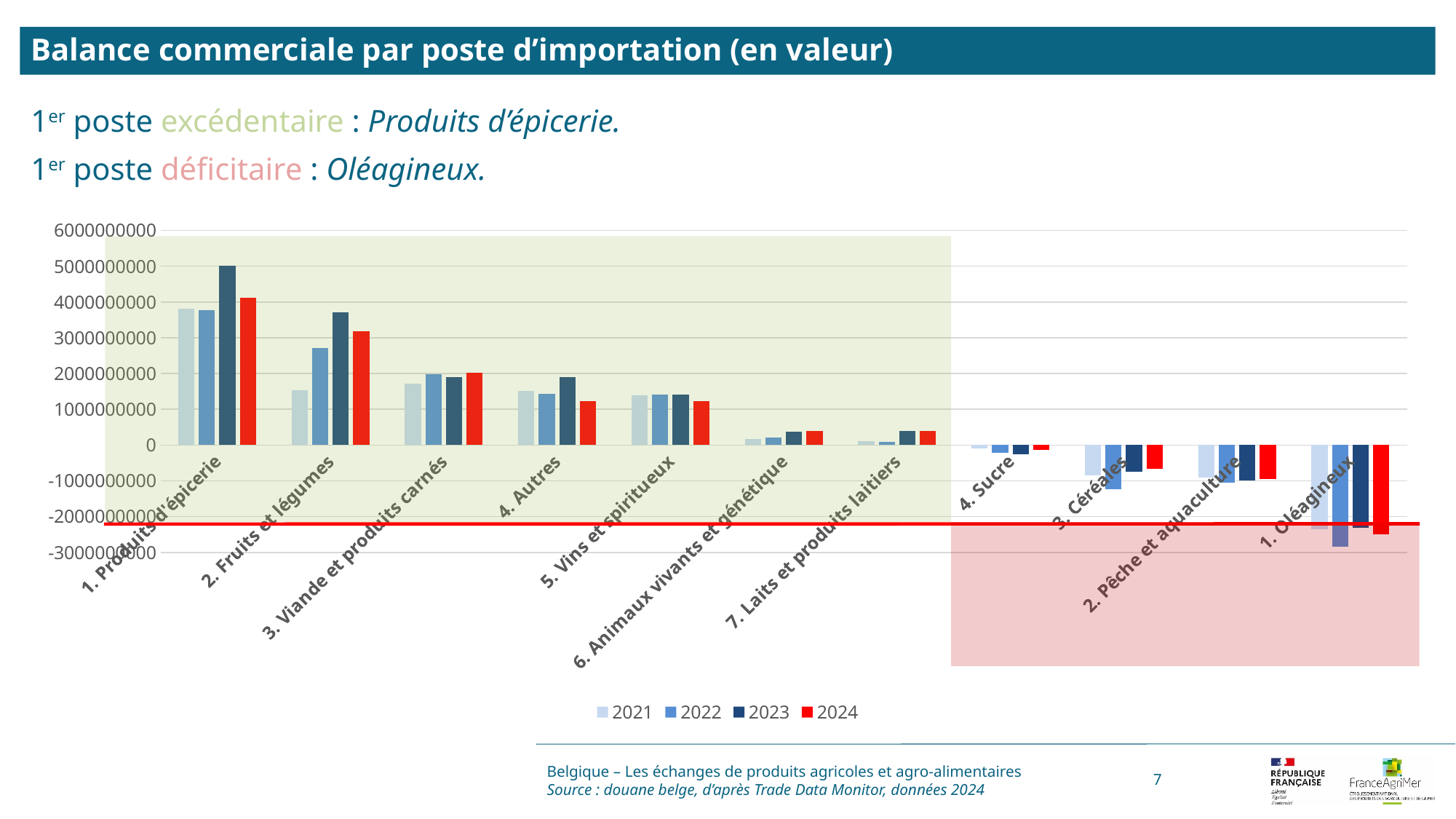
Which category has the highest value for 2024? 1. Produits d'épicerie How many series does the legend list? 4 What kind of chart is shown on the slide? bar chart What colour represents the 2024 series in the legend? red Is the 2024 value for 3. Céréales greater or less than -1000000000? greater How many categories are shown on the x axis? 11 Is the 2021 value for 2. Fruits et légumes greater or less than 1000000000? greater Is the 2022 value for 1. Oléagineux greater or less than -2000000000? less Which category has the lowest value for 2022? 1. Oléagineux Which is larger, the 2023 value for 1. Produits d'épicerie or the 2023 value for 2. Fruits et légumes? 1. Produits d'épicerie Do the 2024 values rise or fall moving from left to right along the x axis? fall